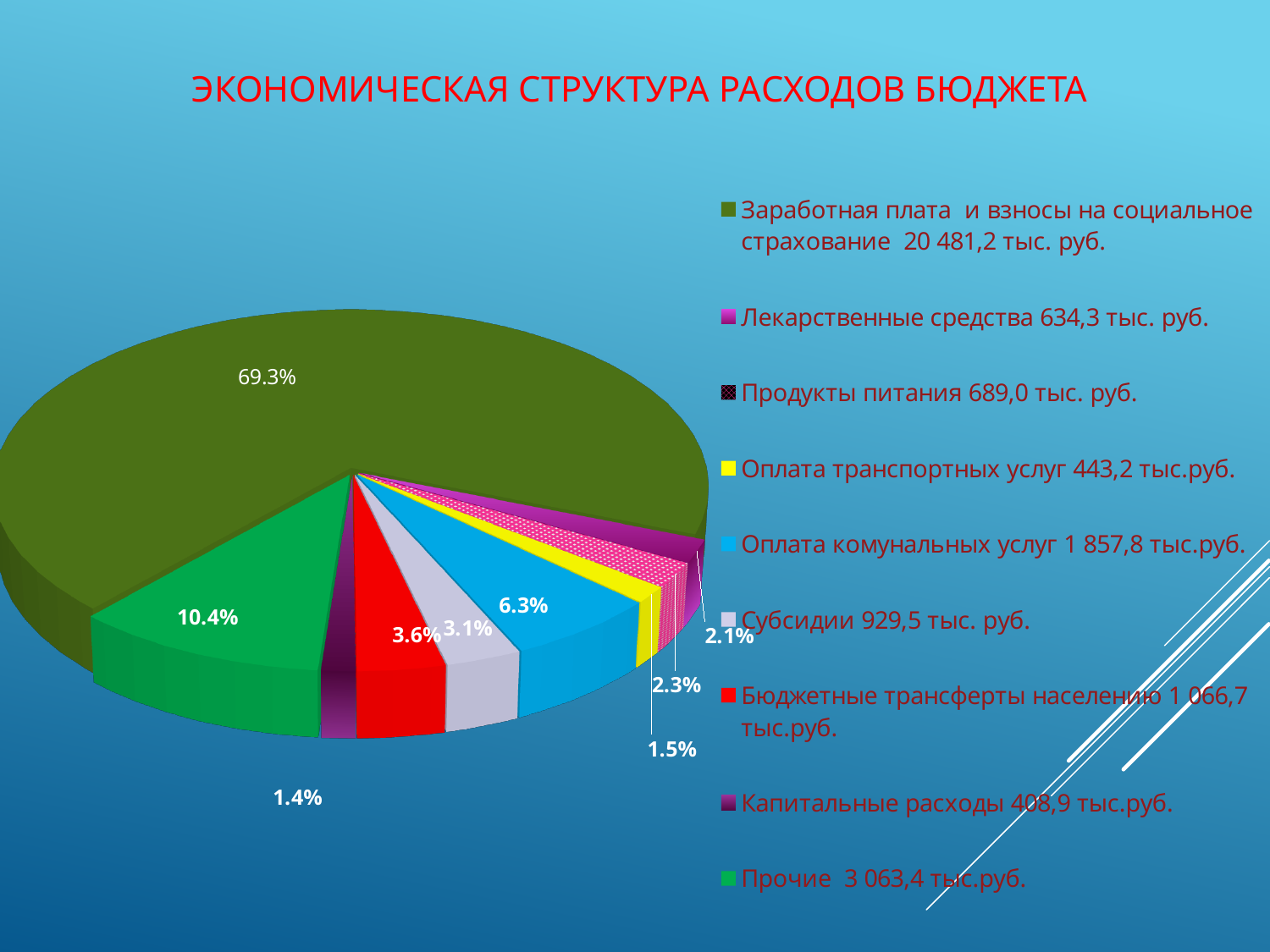
What is the title of the chart? ЭКОНОМИЧЕСКАЯ СТРУКТУРА РАСХОДОВ БЮДЖЕТА Which category has the largest slice of the pie? Заработная плата и взносы на социальное страхование What share of the pie does the slice for Оплата коммунальных услуг have? 6.3% What share of the pie does the slice for Капитальные расходы have? 1.4% What share of the pie does the slice for Бюджетные трансферты населению have? 3.6% Which category has the smallest slice of the pie? Капитальные расходы What is the difference in percentage points between the share for Прочие and the share for Оплата коммунальных услуг? 4.1 Which is larger, the share for Субсидии or the share for Оплата коммунальных услуг? Оплата коммунальных услуг How many categories does the legend list? 9 What kind of chart is shown on the slide? pie chart